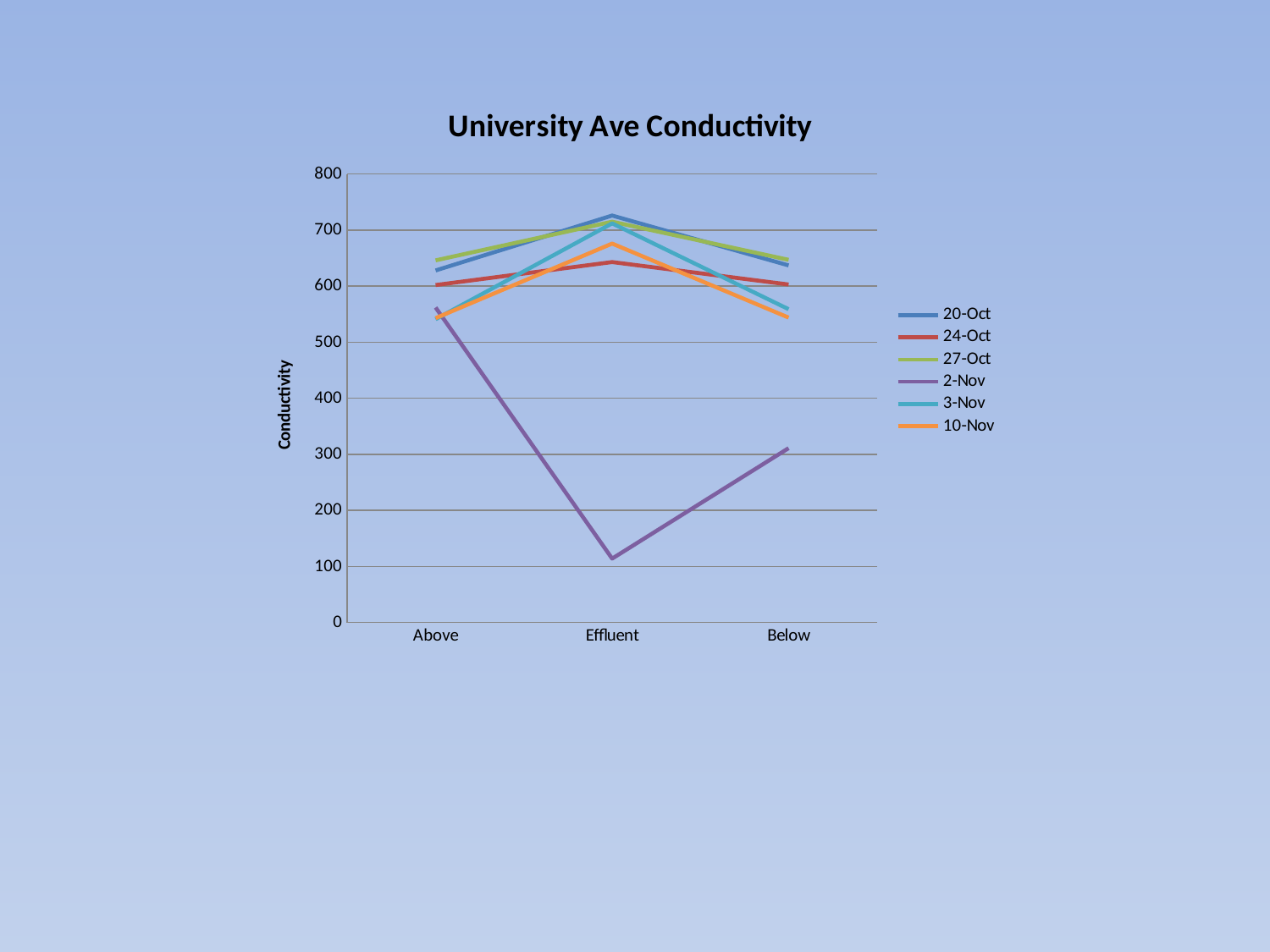
Which series has the lowest value at Below? 2-Nov Which is larger for the 2-Nov series: the value at Above or the value at Below? Above Is the value for 20-Oct at Effluent greater or less than 700? greater How many categories are shown on the x axis? 3 Which series has the lowest value at Effluent? 2-Nov Is the value for 24-Oct at Effluent greater or less than 700? less What kind of chart is shown on the slide? Line chart Does the 2-Nov series rise or fall from Above to Effluent? Fall How many series does the legend list? 6 Is the value for 2-Nov at Effluent greater or less than 200? less What is the title of the chart? University Ave Conductivity What is the label of the vertical axis? Conductivity